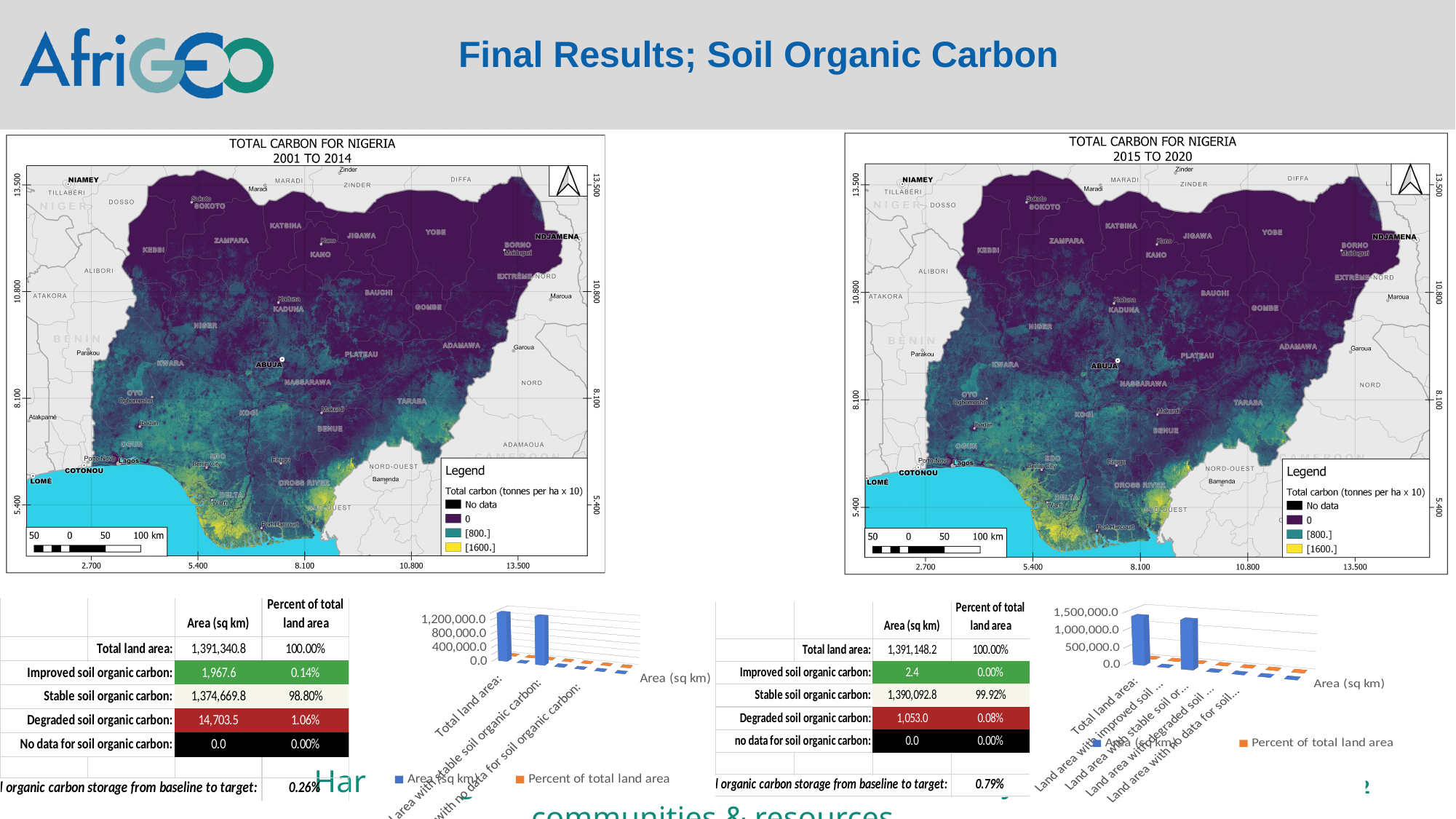
In the right-hand bar chart, is the Area (sq km) value for Land area with degraded soil greater or less than 500,000.0? less In the left-hand bar chart, is the Area (sq km) value for Improved soil organic carbon greater or less than 400,000.0? less In the right-hand bar chart, which is larger for the Area (sq km) series: Total land area or Land area with improved soil? Total land area What are the two series named in the legend of the right-hand bar chart? Area (sq km) and Percent of total land area What kind of chart is the left-hand chart below the maps? bar chart In the left-hand bar chart, which series is drawn in orange? Percent of total land area In the left-hand bar chart, is the Area (sq km) value for Total land area greater or less than 1,200,000.0? greater How many series does the legend of the left-hand bar chart list? 2 What is the highest tick value shown on the vertical axis of the right-hand bar chart? 1,500,000.0 In the left-hand bar chart, which is larger for the Area (sq km) series: Total land area or Improved soil organic carbon? Total land area